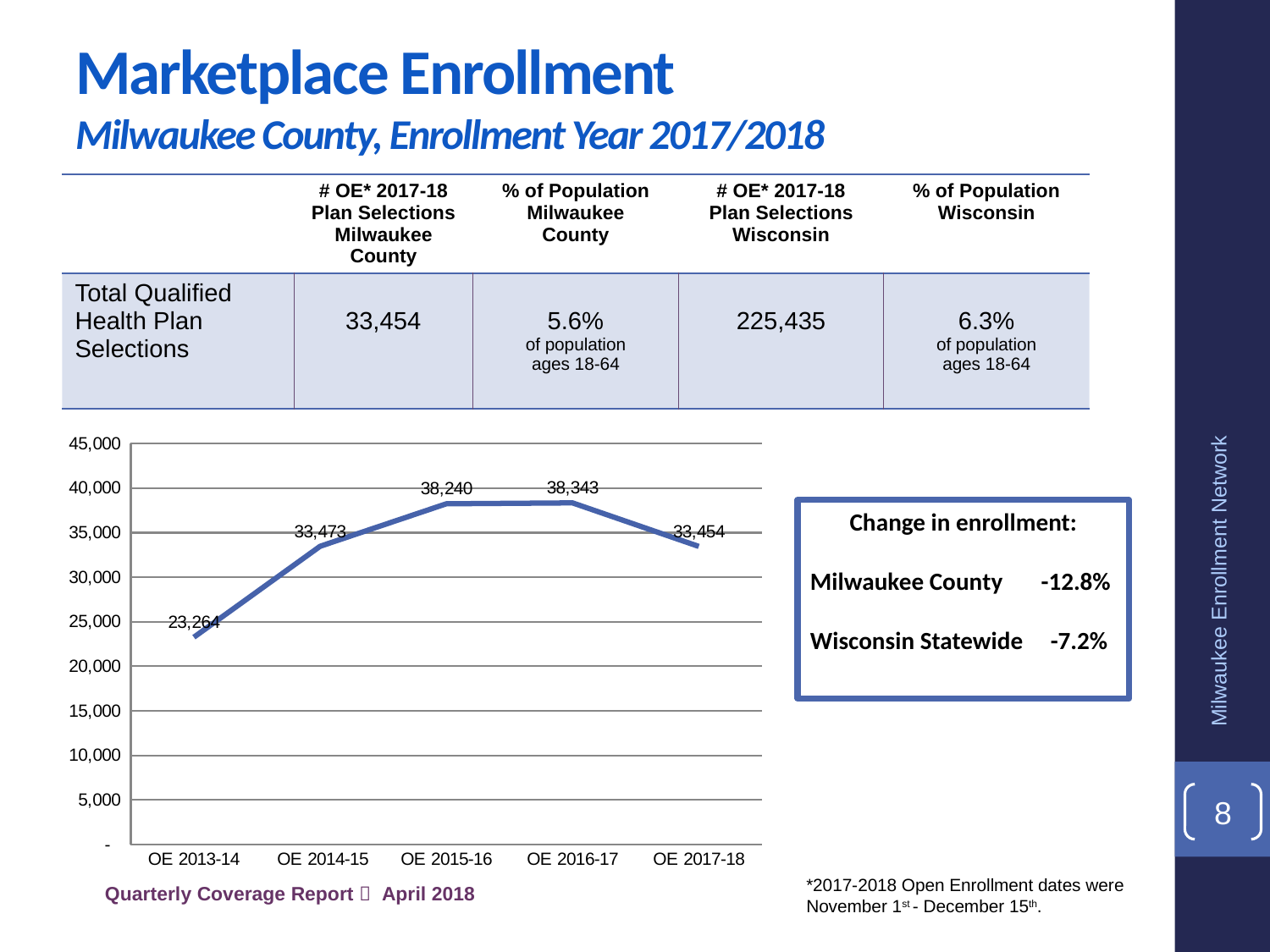
Which enrollment period has the lowest value? OE 2013-14 Which is larger, the value for OE 2014-15 or OE 2017-18? OE 2014-15 What is the value for OE 2013-14? 23,264 Does the value rise or fall from OE 2016-17 to OE 2017-18? fall What is the value for OE 2015-16? 38,240 Which enrollment period has the highest value? OE 2016-17 How many enrollment periods are plotted on the x axis? 5 What is the value for OE 2017-18? 33,454 What is the difference between the values for OE 2014-15 and OE 2013-14? 10,209 What is the difference between the values for OE 2016-17 and OE 2017-18? 4,889 Is the value for OE 2013-14 greater or less than 25,000? less What type of chart is shown on the slide? line chart